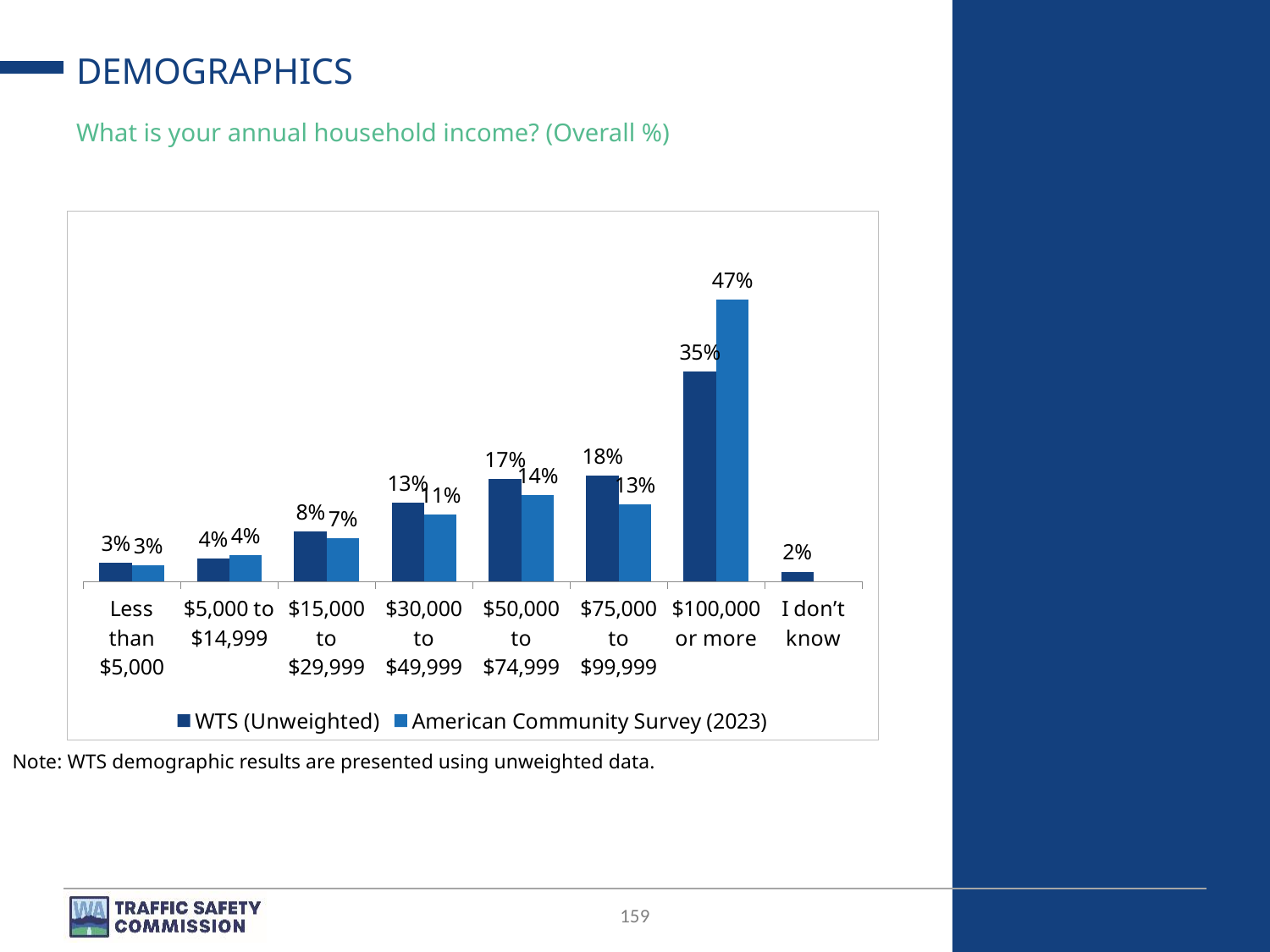
Which category has the lowest WTS (Unweighted) value? I don't know What is the WTS (Unweighted) value for the I don't know category? 2% What is the American Community Survey (2023) value for the $30,000 to $49,999 category? 11% What is the American Community Survey (2023) value for the $100,000 or more category? 47% What is the WTS (Unweighted) value for the $75,000 to $99,999 category? 18% What kind of chart is shown on the slide? Bar chart What is the difference between the American Community Survey (2023) and WTS (Unweighted) values for the $100,000 or more category? 12 percentage points How many series does the legend list? 2 What is the WTS (Unweighted) value for the $100,000 or more category? 35% Which is larger for the $75,000 to $99,999 category: WTS (Unweighted) or American Community Survey (2023)? WTS (Unweighted) How many income categories are shown on the x axis? 8 Which category has the highest WTS (Unweighted) value? $100,000 or more